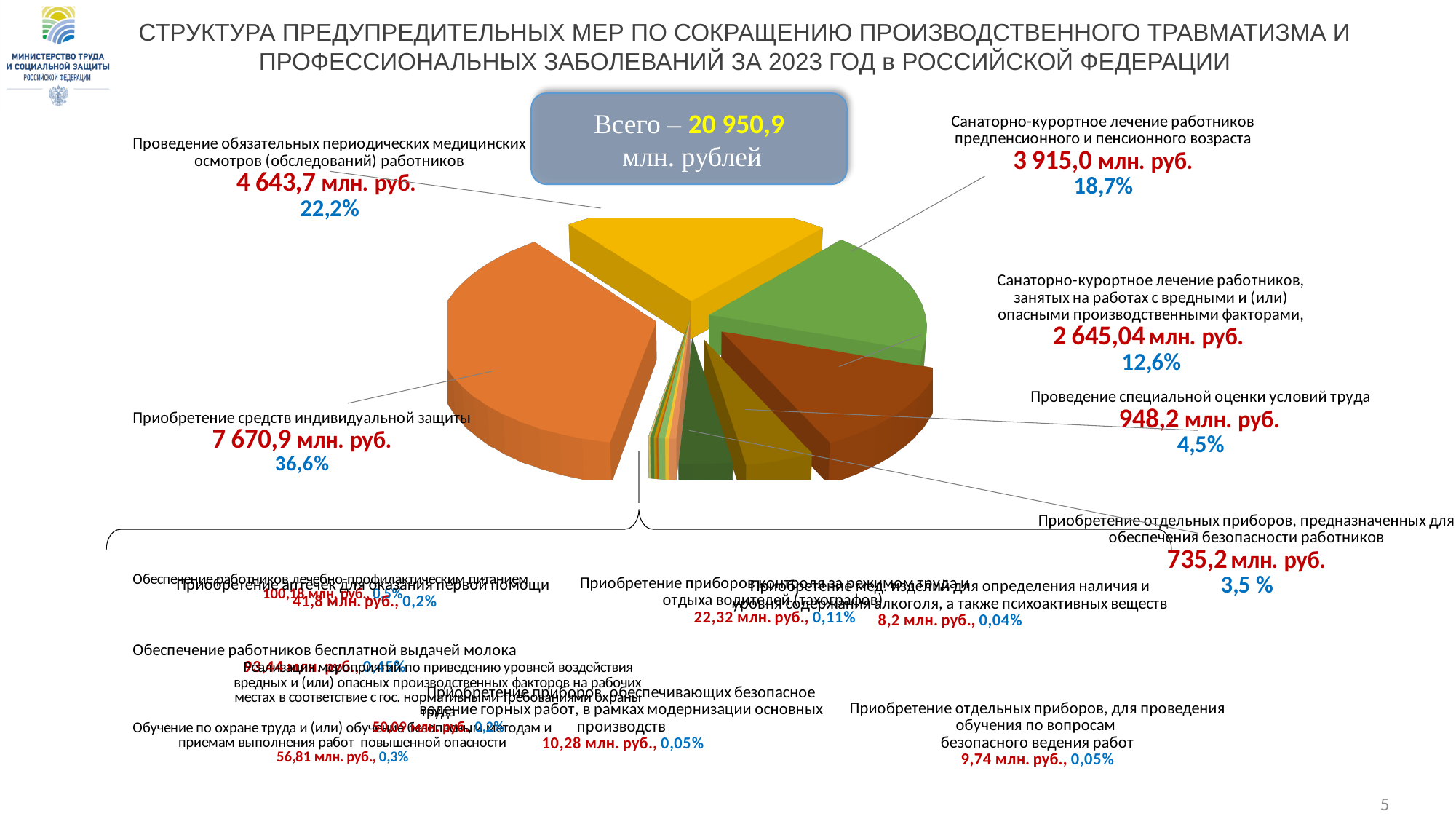
What is the total amount shown in the box above the pie chart? 20 950,9 млн. рублей Which category has the largest share of the pie? Приобретение средств индивидуальной защиты What kind of chart is shown on the slide? pie chart What is the value for «Приобретение приборов контроля за режимом труда и отдыха водителей (тахографов)»? 22,32 млн. руб. What is the difference in млн. руб. between «Приобретение средств индивидуальной защиты» (7 670,9) and «Проведение обязательных периодических медицинских осмотров (обследований) работников» (4 643,7)? 3 027,2 млн. руб. What is the value for «Приобретение средств индивидуальной защиты»? 7 670,9 млн. руб. What percentage is shown for «Санаторно-курортное лечение работников предпенсионного и пенсионного возраста»? 18,7% What is the value for «Приобретение отдельных приборов, предназначенных для обеспечения безопасности работников»? 735,2 млн. руб. Which is larger: «Санаторно-курортное лечение работников предпенсионного и пенсионного возраста» or «Санаторно-курортное лечение работников, занятых на работах с вредными и (или) опасными производственными факторами»? Санаторно-курортное лечение работников предпенсионного и пенсионного возраста What is the value for «Проведение специальной оценки условий труда»? 948,2 млн. руб. What share of the pie does «Приобретение средств индивидуальной защиты» represent? 36,6% For which year does the chart show the structure of preventive measures, according to the title? 2023